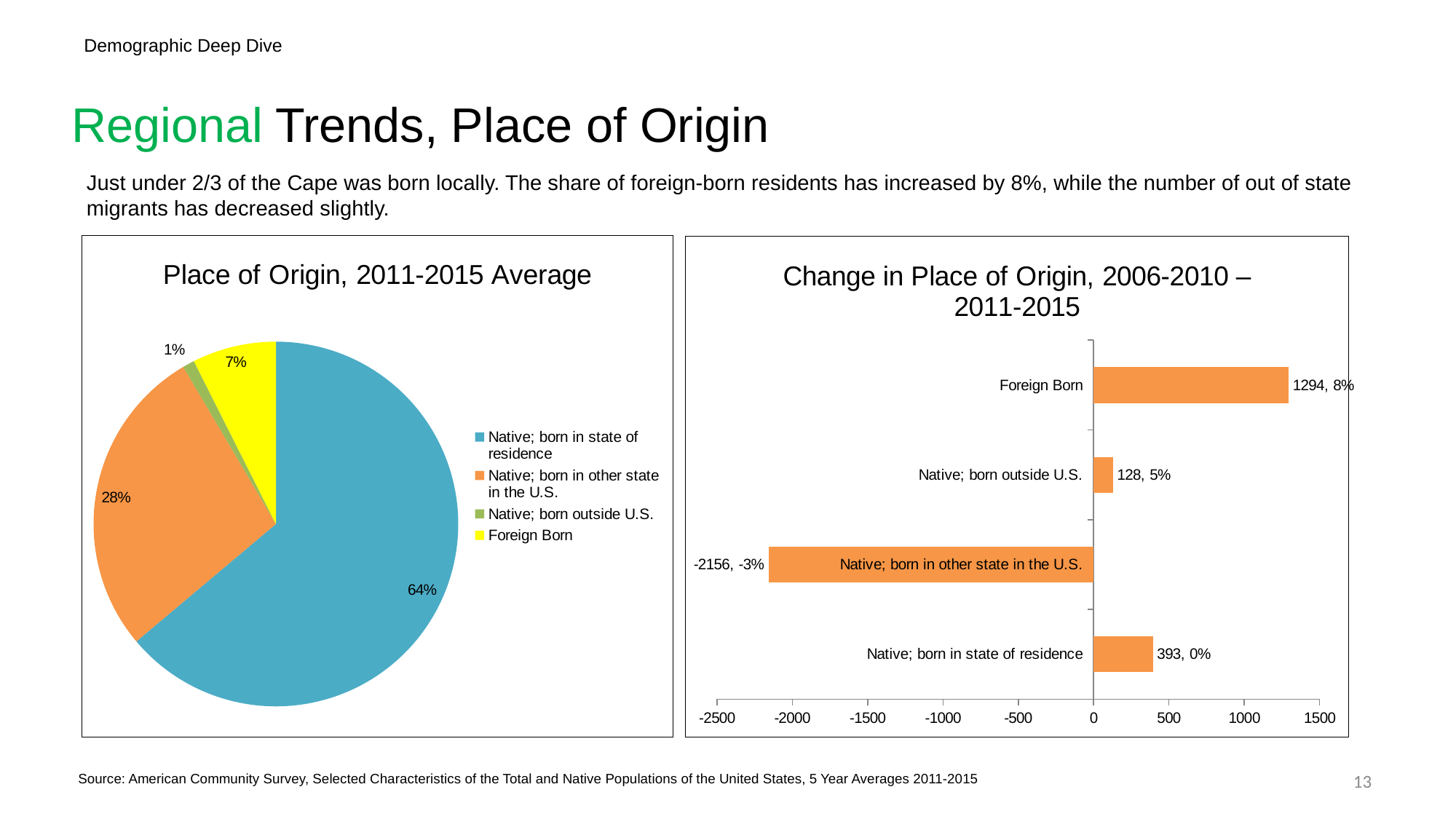
In the 'Change in Place of Origin, 2006-2010 – 2011-2015' chart, what is the data label for 'Foreign Born'? 1294, 8% In the 'Place of Origin, 2011-2015 Average' chart, which category has the largest slice? Native; born in state of residence In the 'Change in Place of Origin, 2006-2010 – 2011-2015' chart, which is larger: the value for 'Foreign Born' or the value for 'Native; born in state of residence'? Foreign Born In the 'Place of Origin, 2011-2015 Average' chart, what share of the pie is 'Foreign Born'? 7% In the 'Change in Place of Origin, 2006-2010 – 2011-2015' chart, which category has the lowest value? Native; born in other state in the U.S. What kind of chart is 'Place of Origin, 2011-2015 Average'? Pie chart In the 'Place of Origin, 2011-2015 Average' chart, what share of the pie is 'Native; born in state of residence'? 64% In the 'Place of Origin, 2011-2015 Average' chart, how many categories does the legend list? 4 In the 'Place of Origin, 2011-2015 Average' chart, which category has the smallest slice? Native; born outside U.S. What kind of chart is 'Change in Place of Origin, 2006-2010 – 2011-2015'? Bar chart In the 'Change in Place of Origin, 2006-2010 – 2011-2015' chart, what is the difference between the values for 'Foreign Born' (1294) and 'Native; born in state of residence' (393)? 901 In the 'Change in Place of Origin, 2006-2010 – 2011-2015' chart, what is the data label for 'Native; born in other state in the U.S.'? -2156, -3%